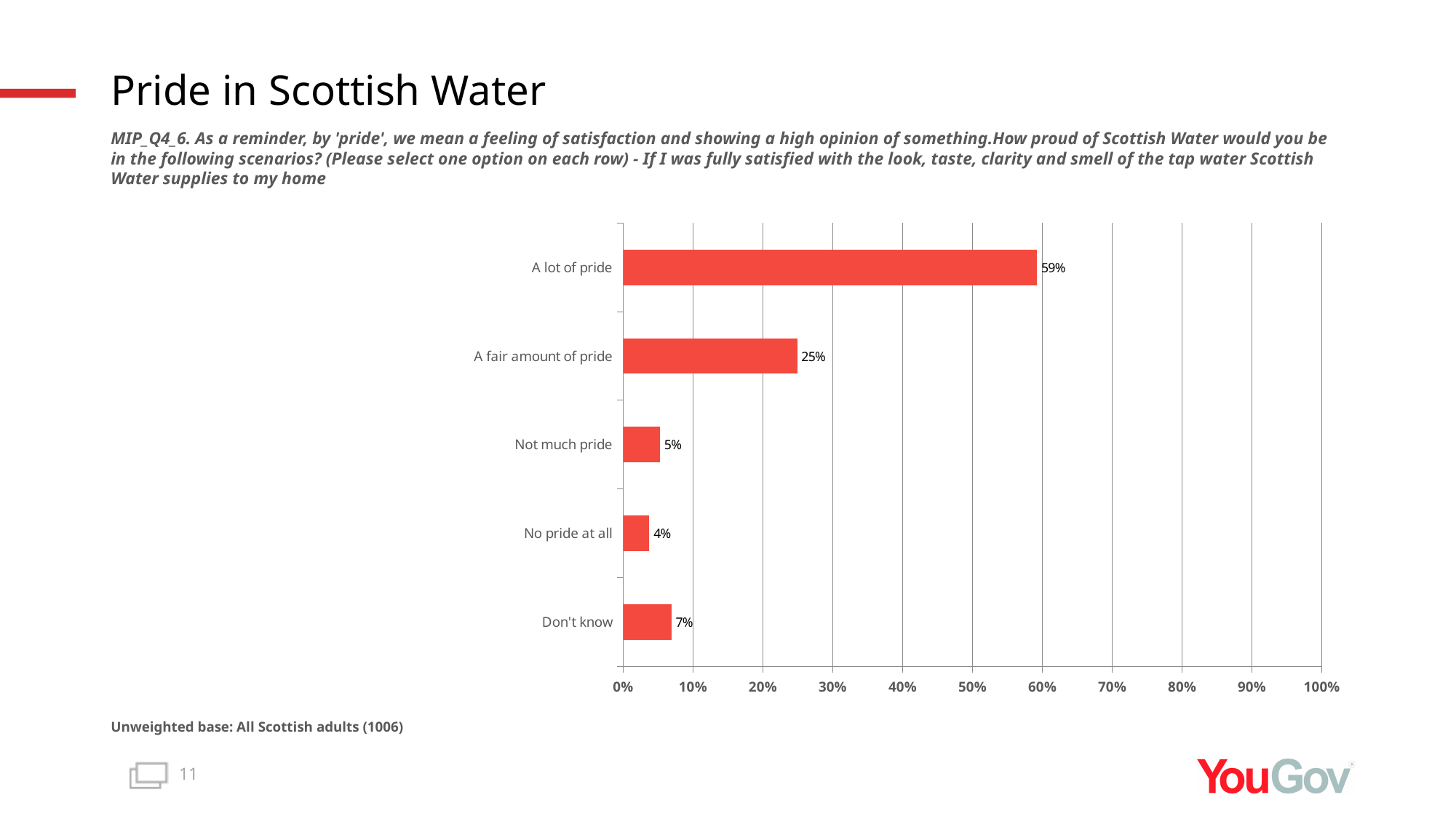
What is the difference between 'Not much pride' and 'No pride at all'? 1% What percentage is shown for 'Don't know'? 7% Which category has the lowest value? No pride at all Which is larger, 'Don't know' or 'Not much pride'? Don't know Which category has the highest value? A lot of pride What is the value shown for 'A fair amount of pride'? 25% What is the unweighted base stated below the chart? All Scottish adults (1006) How many categories are shown in the chart? 5 What kind of chart is shown on the slide? Bar chart What percentage of respondents said they would feel 'A lot of pride'? 59% Is the value for 'A lot of pride' greater or less than 50%? greater What is the difference between 'A lot of pride' and 'A fair amount of pride'? 34%